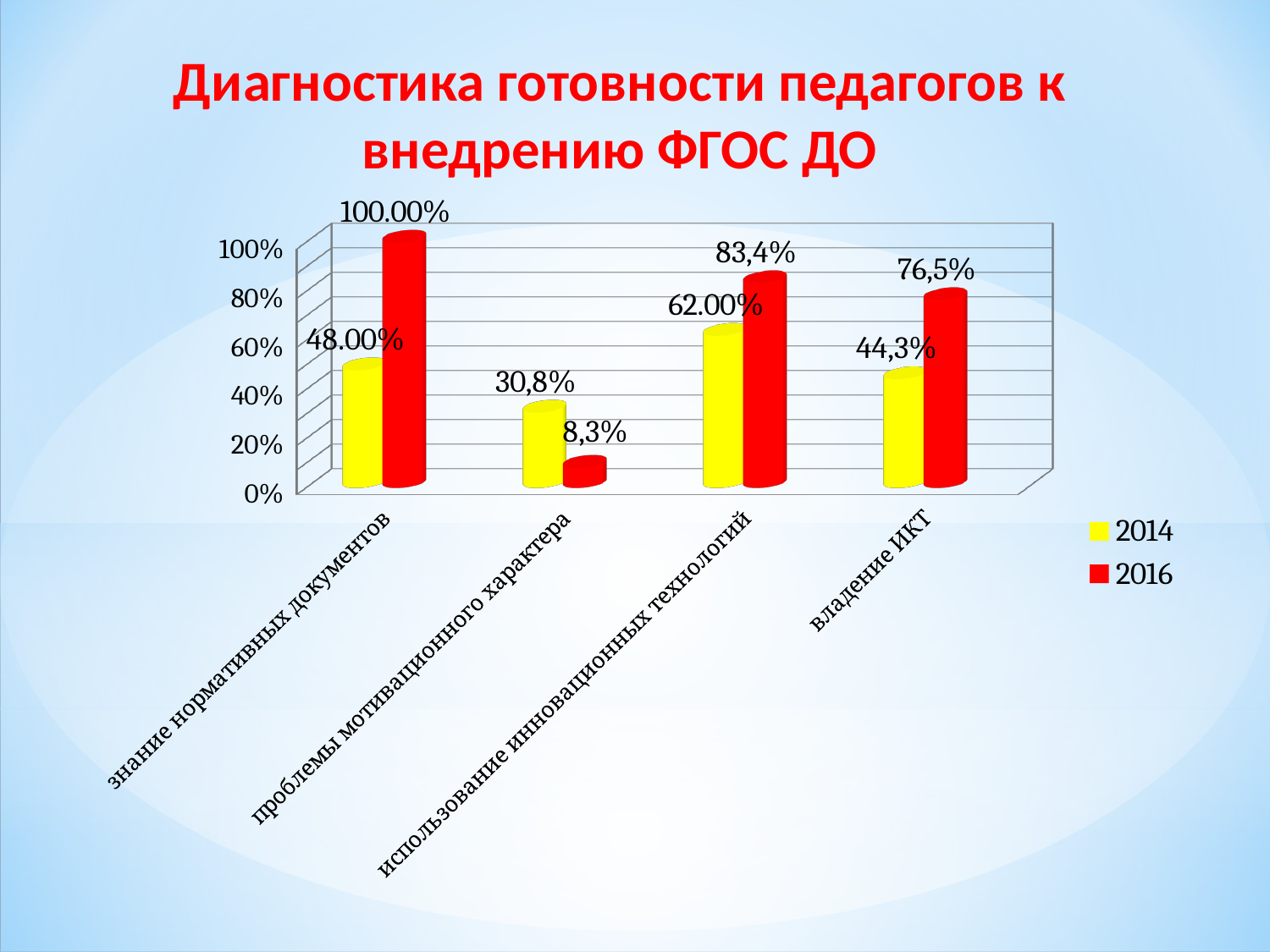
How many categories are shown on the x axis? 4 What is the 2016 value for использование инновационных технологий? 83,4% Which is larger for проблемы мотивационного характера: the 2014 value or the 2016 value? 2014 How many series does the legend list? 2 What type of chart is shown on the slide? bar chart Which category has the highest 2014 value? использование инновационных технологий What is the 2014 value for владение ИКТ? 44,3% Which colour represents the 2016 series in the legend? red Which category has the lowest 2016 value? проблемы мотивационного характера What is the 2014 value for проблемы мотивационного характера? 30,8% What is the 2016 value for знание нормативных документов? 100.00% By how many percentage points does the 2016 value for знание нормативных документов exceed the 2014 value? 52